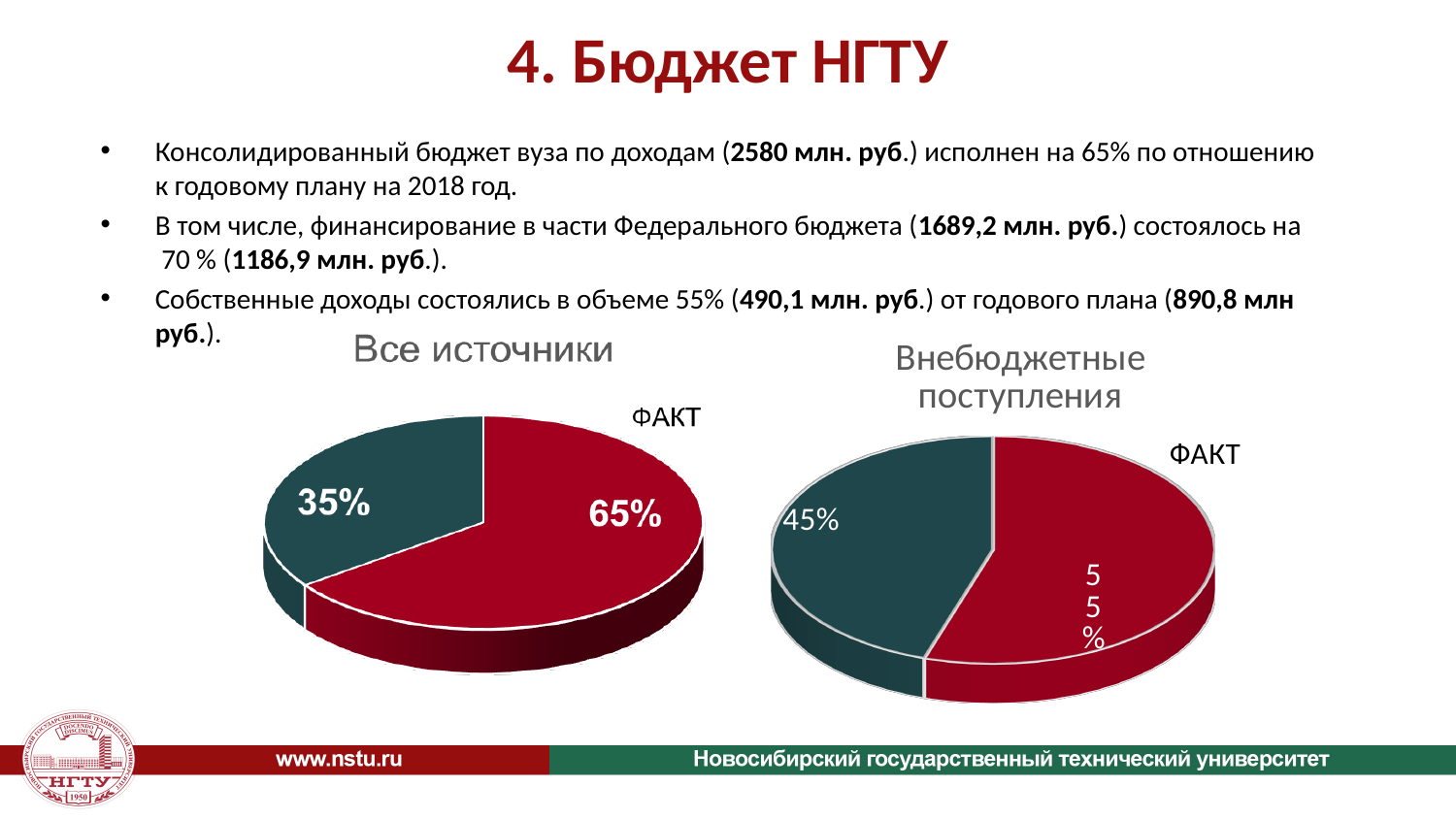
In the "Все источники" chart, what share does the ФАКТ slice have? 65% How many pie charts are shown on the slide? 2 In the "Все источники" chart, what share does the teal (non-ФАКТ) slice have? 35% What kind of chart is the "Все источники" chart? pie chart What is the title of the pie chart on the right side of the slide? Внебюджетные поступления In the "Внебюджетные поступления" chart, what is the difference in percentage points between the ФАКТ slice and the teal slice? 10 In the "Внебюджетные поступления" chart, what share does the ФАКТ slice have? 55% In the "Внебюджетные поступления" chart, which slice is the largest? ФАКТ In the "Все источники" chart, what is the difference in percentage points between the ФАКТ slice and the teal slice? 30 In the "Все источники" chart, which slice is larger, ФАКТ or the teal slice? ФАКТ How many slices does the "Все источники" pie chart have? 2 In the "Внебюджетные поступления" chart, what share does the teal (non-ФАКТ) slice have? 45%